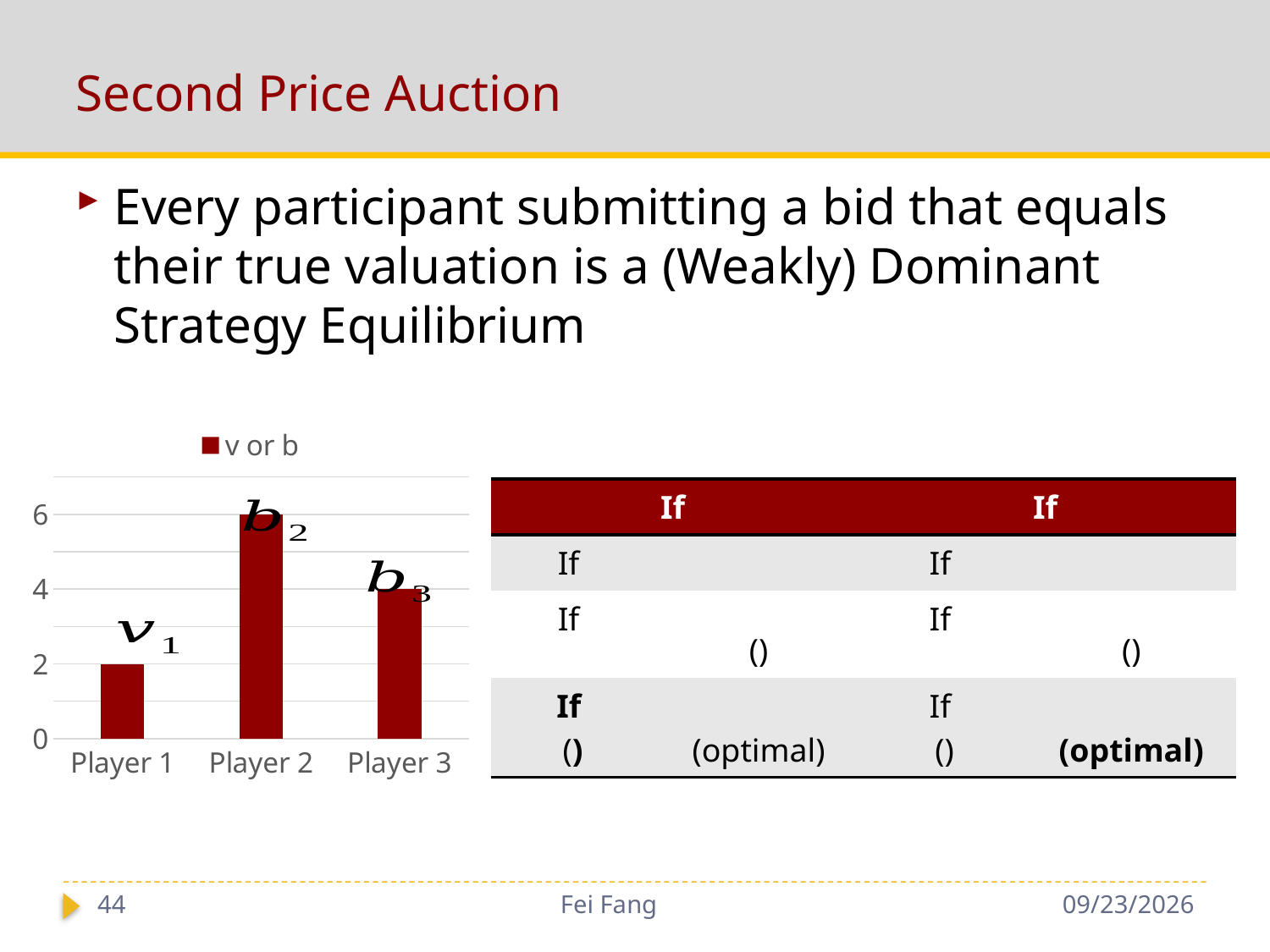
Which is larger, the bar for Player 3 or the bar for Player 1? Player 3 What is the name of the series in the chart legend? v or b What is the value of the bar for Player 3? 4 How many players (categories) are shown on the x axis of the chart? 3 What is the value of the bar for Player 1? 2 How many series does the chart legend list? 1 Which player has the lowest bar in the chart? Player 1 What is the value of the bar for Player 2? 6 What type of chart is shown on the slide? bar chart Which player has the highest bar in the chart? Player 2 What is the difference between the bar values for Player 2 and Player 3? 2 Is the value for Player 2 greater or less than 4? greater